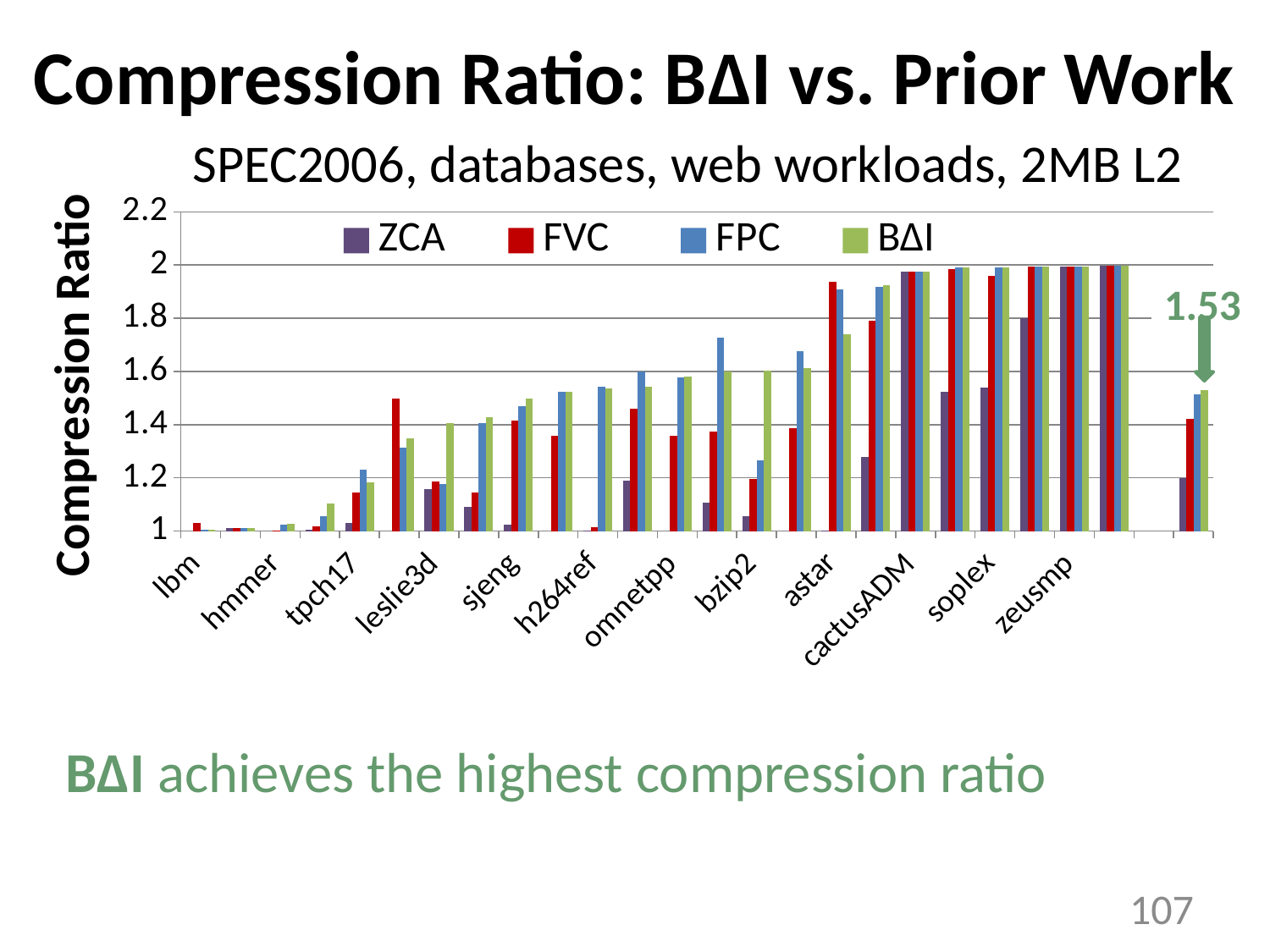
What is the highest tick value shown on the vertical axis? 2.2 What is the title of the vertical axis? Compression Ratio What value is annotated above the BΔI bar in the rightmost group of the chart? 1.53 Is the ZCA value in the rightmost group greater or less than 1.4? less In the rightmost group of bars, which is larger, the ZCA value or the BΔI value? BΔI In the rightmost group of bars, which series has the lowest value? ZCA How many series does the legend list? 4 What kind of chart is shown on the slide? bar chart Which series are listed in the legend? ZCA, FVC, FPC, BΔI Do the BΔI values generally rise or fall from lbm on the left to zeusmp on the right? rise Is the FVC value for zeusmp greater or less than 1.8? greater Is the BΔI value for lbm greater or less than 1.2? less